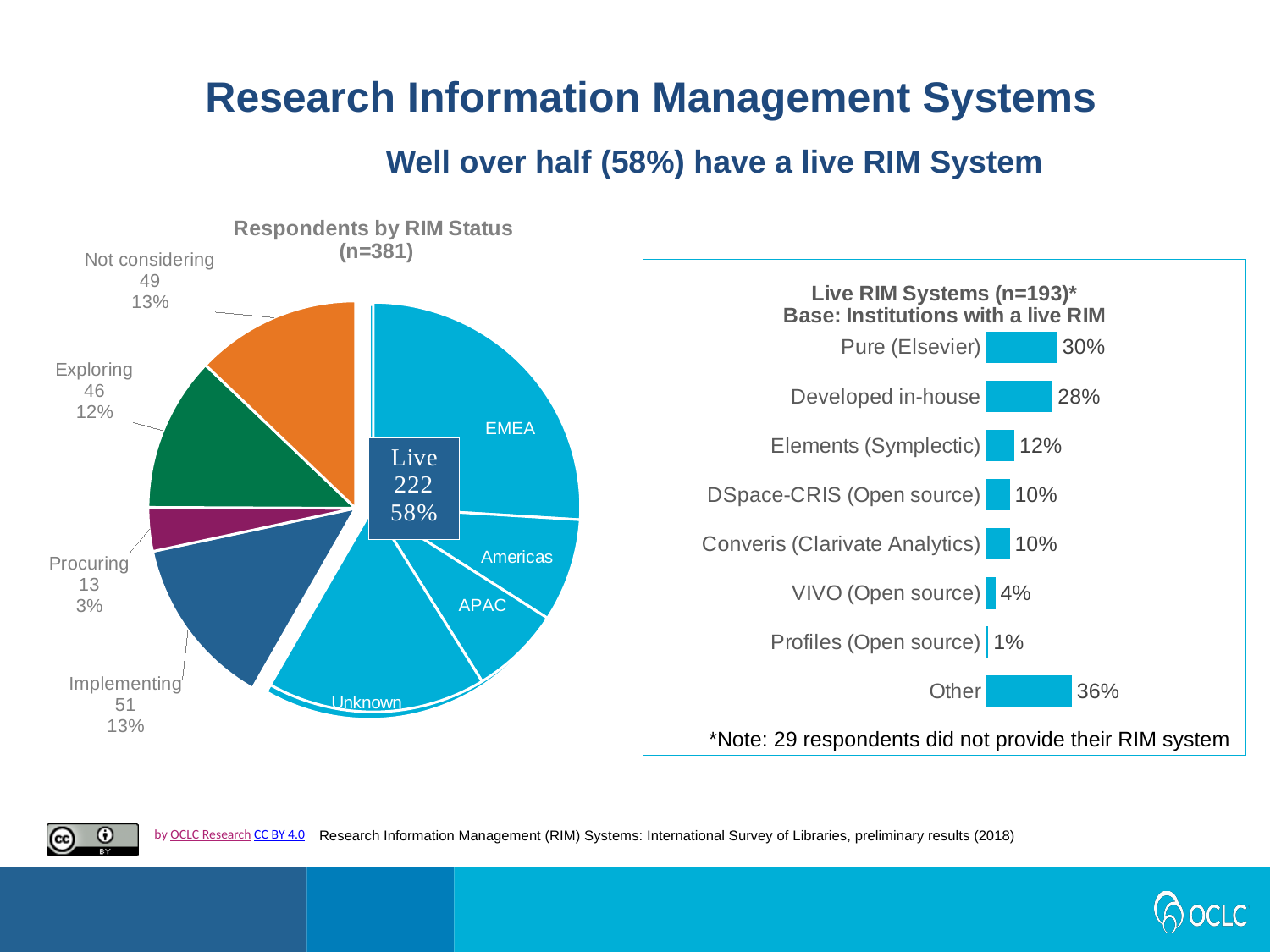
What is the total number of respondents (n) stated in the title of the 'Respondents by RIM Status' pie chart? 381 What kind of chart is the 'Live RIM Systems' chart? Bar chart In the 'Respondents by RIM Status' pie chart, how many respondents are in the Live category? 222 How many categories are shown in the 'Live RIM Systems' bar chart? 8 In the 'Respondents by RIM Status' pie chart, what is the difference in respondent count between Implementing and Exploring? 5 In the 'Live RIM Systems' bar chart, which category has the highest percentage? Other In the 'Live RIM Systems' bar chart, which is larger: VIVO (Open source) or DSpace-CRIS (Open source)? DSpace-CRIS (Open source) In the 'Live RIM Systems' bar chart, which category has the lowest percentage? Profiles (Open source) In the 'Respondents by RIM Status' pie chart, what share of respondents are Procuring? 3% In the 'Live RIM Systems' bar chart, what is the difference in percentage points between Pure (Elsevier) and Elements (Symplectic)? 18 In the 'Live RIM Systems' bar chart, what percentage is shown for Pure (Elsevier)? 30% In the 'Live RIM Systems' bar chart, what percentage is shown for Developed in-house? 28%